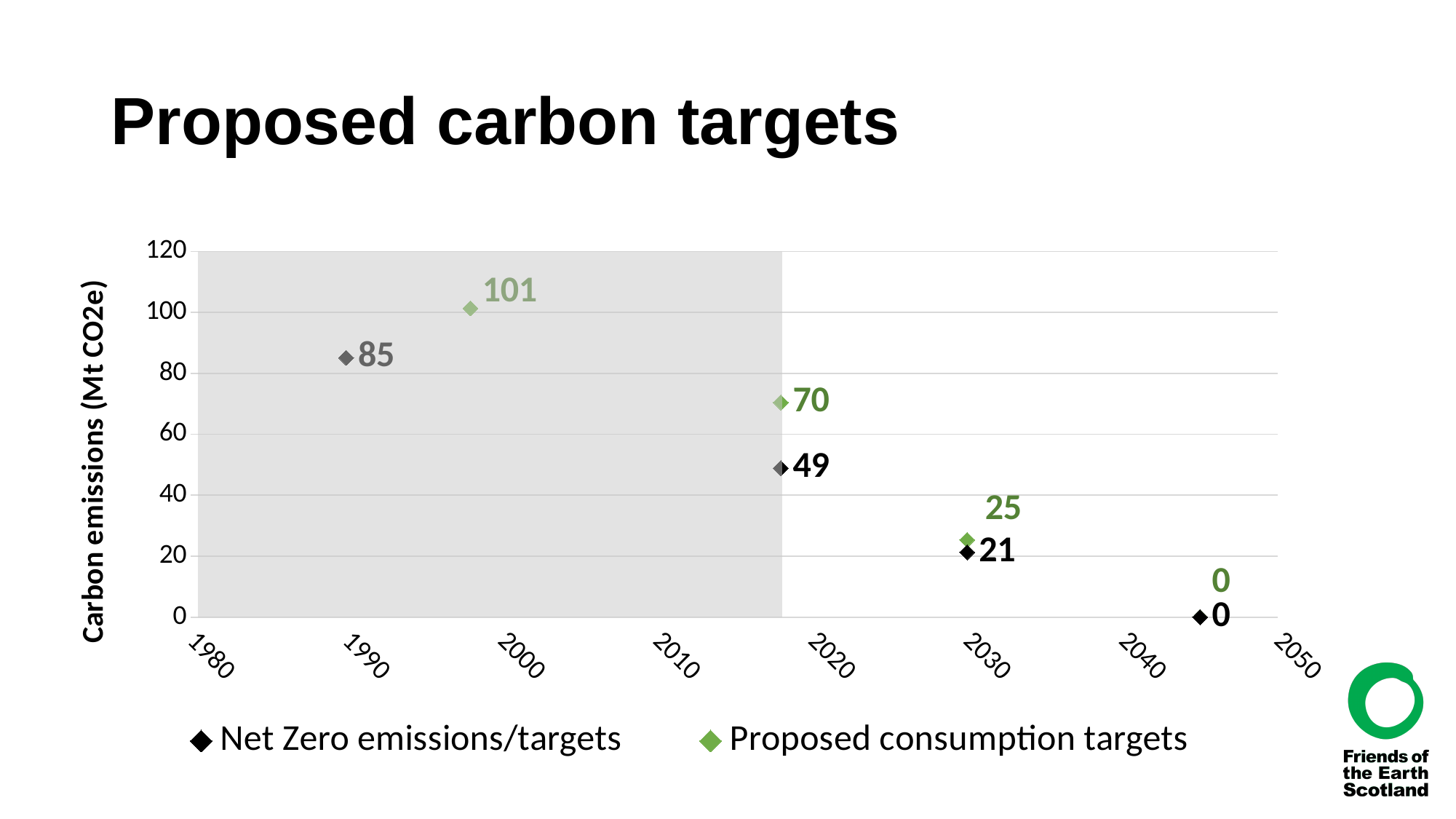
What is the y-axis label of the chart? Carbon emissions (Mt CO2e) What is the highest labelled value for the Proposed consumption targets series? 101 What is the difference between the Proposed consumption targets value (70) and the Net Zero emissions/targets value (49) at the points just before 2020? 21 What value do both series reach at their final point, between 2040 and 2050? 0 What is the highest labelled value for the Net Zero emissions/targets series? 85 What is the value of the Net Zero emissions/targets point at 2030? 21 At 2030, which series has the larger value: Net Zero emissions/targets or Proposed consumption targets? Proposed consumption targets Do the values of the Proposed consumption targets series rise or fall from 2000 onwards along the x axis? fall How many data points are plotted for the Net Zero emissions/targets series? 4 What type of chart is shown on the slide? scatter chart What is the value of the Proposed consumption targets point at 2030? 25 How many series does the legend list? 2